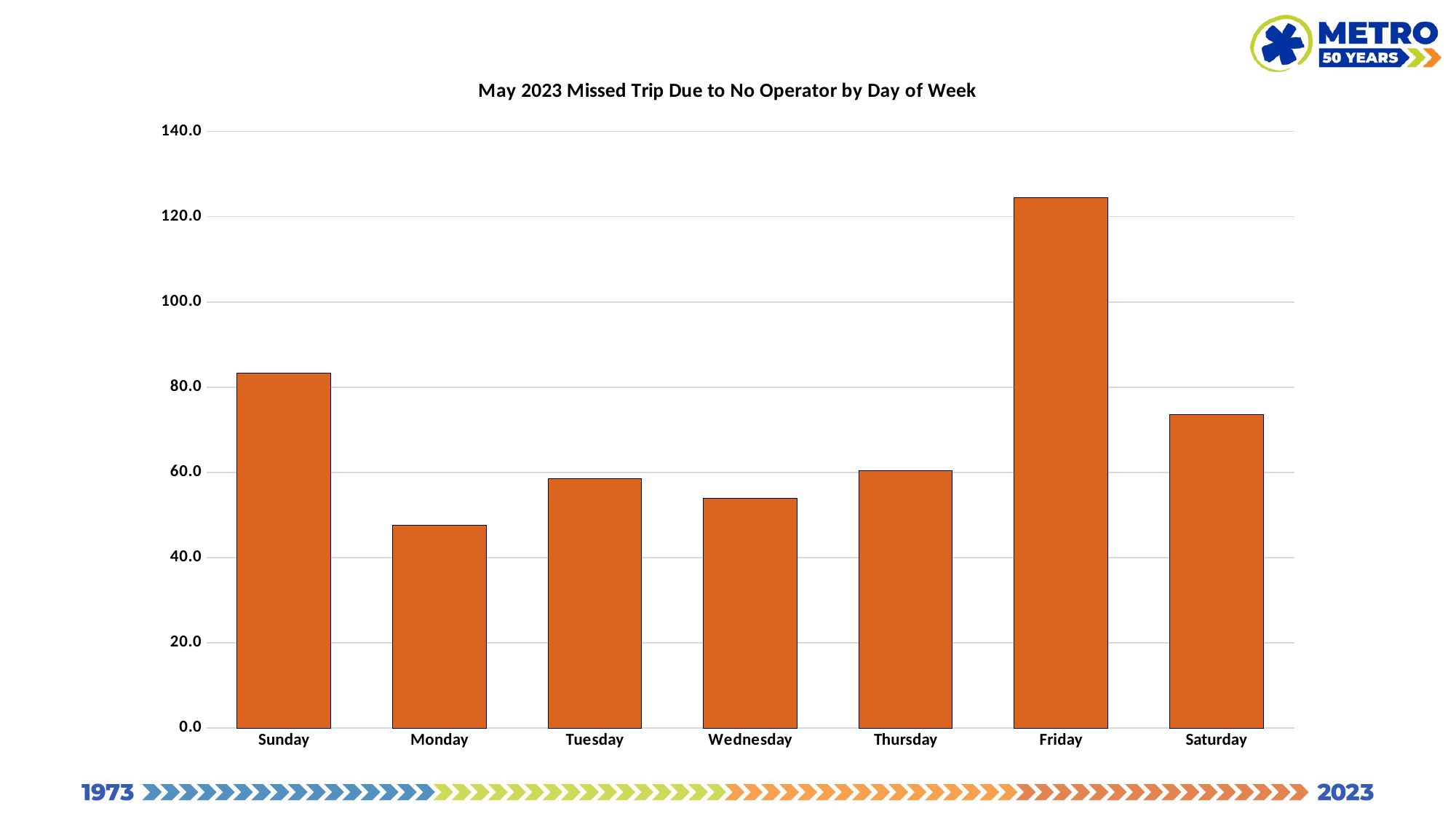
Which has more missed trips, Monday or Thursday? Thursday Is the value for Saturday greater or less than 80? less Which has more missed trips, Sunday or Saturday? Sunday Which day of the week has the highest number of missed trips? Friday What is the title of the chart? May 2023 Missed Trip Due to No Operator by Day of Week Is the value for Friday greater or less than 120? greater What kind of chart is shown on the slide? bar chart Is the value for Wednesday greater or less than 60? less How many days of the week are shown on the x axis? 7 Which day of the week has the lowest number of missed trips? Monday